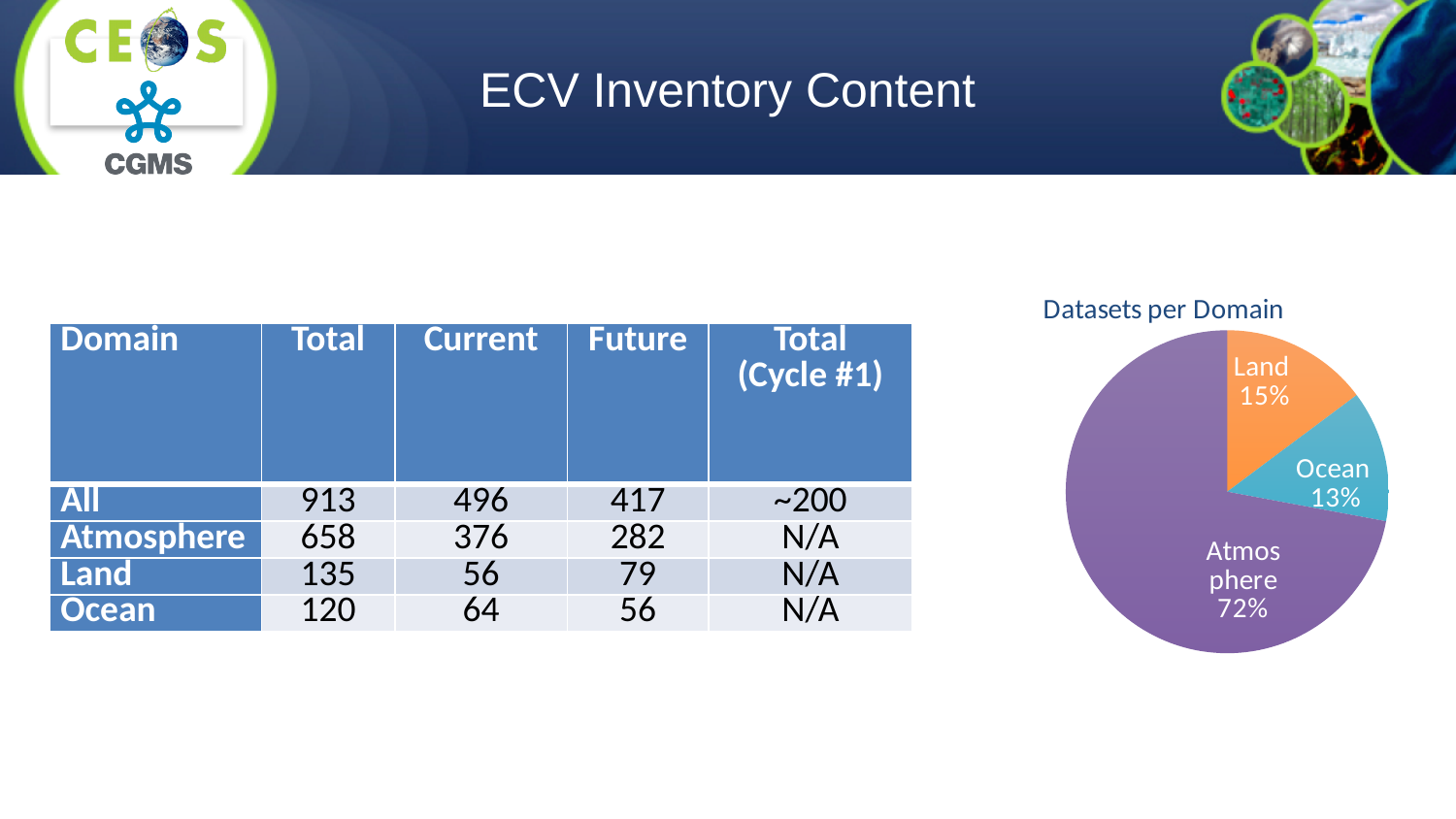
Which slice is larger in the pie chart, Land or Ocean? Land What type of chart is shown on the slide? Pie chart How many slices does the pie chart have? 3 What percentage is shown for Land in the pie chart? 15% By how many percentage points does the Land slice exceed the Ocean slice? 2 What share of the pie chart does Atmosphere represent? 72% By how many percentage points does the Atmosphere slice exceed the Land slice? 57 What is the title of the pie chart? Datasets per Domain What percentage is shown for Ocean in the pie chart? 13% Which domain has the smallest slice in the pie chart? Ocean Which domain has the largest slice in the pie chart? Atmosphere What colour is the Atmosphere slice in the pie chart? Purple